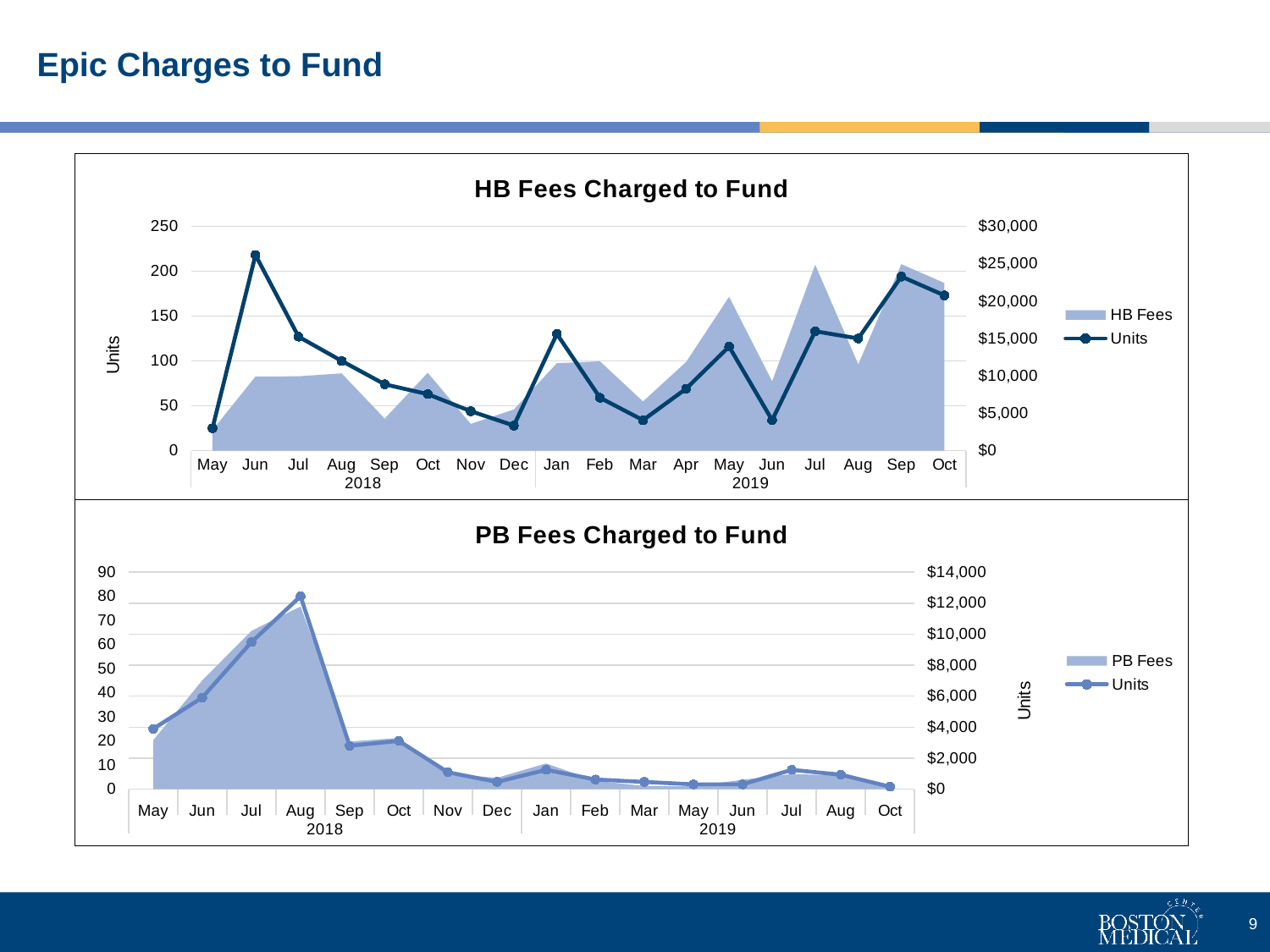
In the "PB Fees Charged to Fund" chart, is the Units value for Aug 2018 greater or less than 70? greater In the "PB Fees Charged to Fund" chart, which is larger, the Units value for Jun 2018 or for Sep 2018? Jun 2018 In the "HB Fees Charged to Fund" chart, is the HB Fees value for Jul 2019 greater or less than $20,000? greater What type of chart is the "HB Fees Charged to Fund" chart? A combination area and line chart In the "HB Fees Charged to Fund" chart, how many months are shown on the x axis? 18 In the "HB Fees Charged to Fund" chart, is the Units value for Jun 2018 greater or less than 200? greater What are the two legend entries in the "PB Fees Charged to Fund" chart? PB Fees and Units In the "HB Fees Charged to Fund" chart, which month has the lowest Units value? May 2018 In the "HB Fees Charged to Fund" chart, do the Units values rise or fall from Jun 2018 to Dec 2018? fall How many series does the legend of the "HB Fees Charged to Fund" chart list? 2 In the "HB Fees Charged to Fund" chart, which month has the highest Units value? Jun 2018 In the "PB Fees Charged to Fund" chart, which month has the highest Units value? Aug 2018